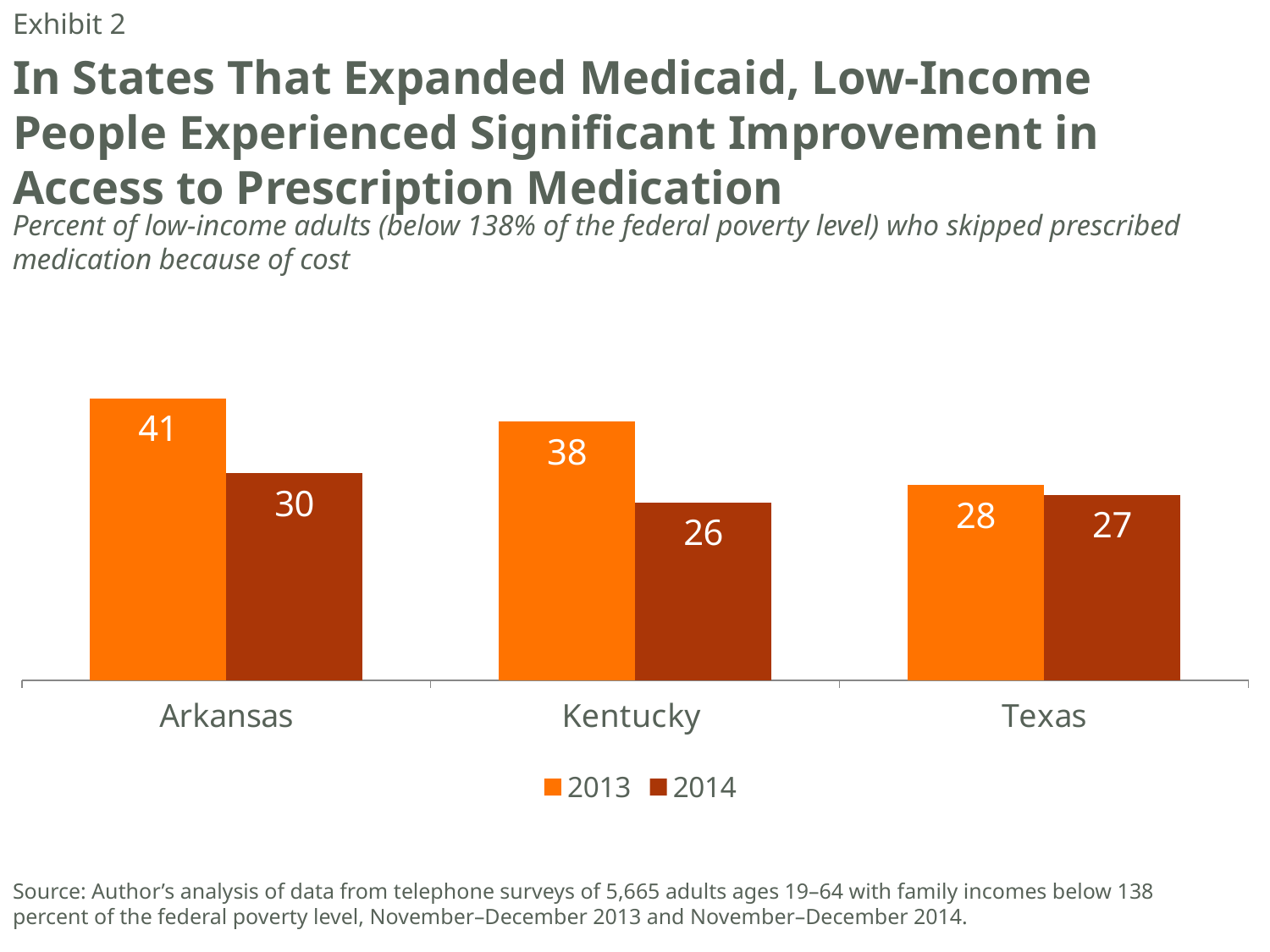
Which years are listed in the legend? 2013 and 2014 What was the value for Arkansas in 2013? 41 How many states are shown on the x axis? 3 What was the value for Texas in 2013? 28 Which state had the lowest value in 2014? Kentucky Which state had the highest value in 2013? Arkansas Which is larger, the 2014 value for Arkansas or the 2014 value for Texas? Arkansas What was the value for Kentucky in 2014? 26 What kind of chart is shown on the slide? Bar chart By how much did the value for Arkansas fall from 2013 to 2014? 11 How many series does the legend list? 2 What is the difference between the 2013 and 2014 values for Kentucky? 12